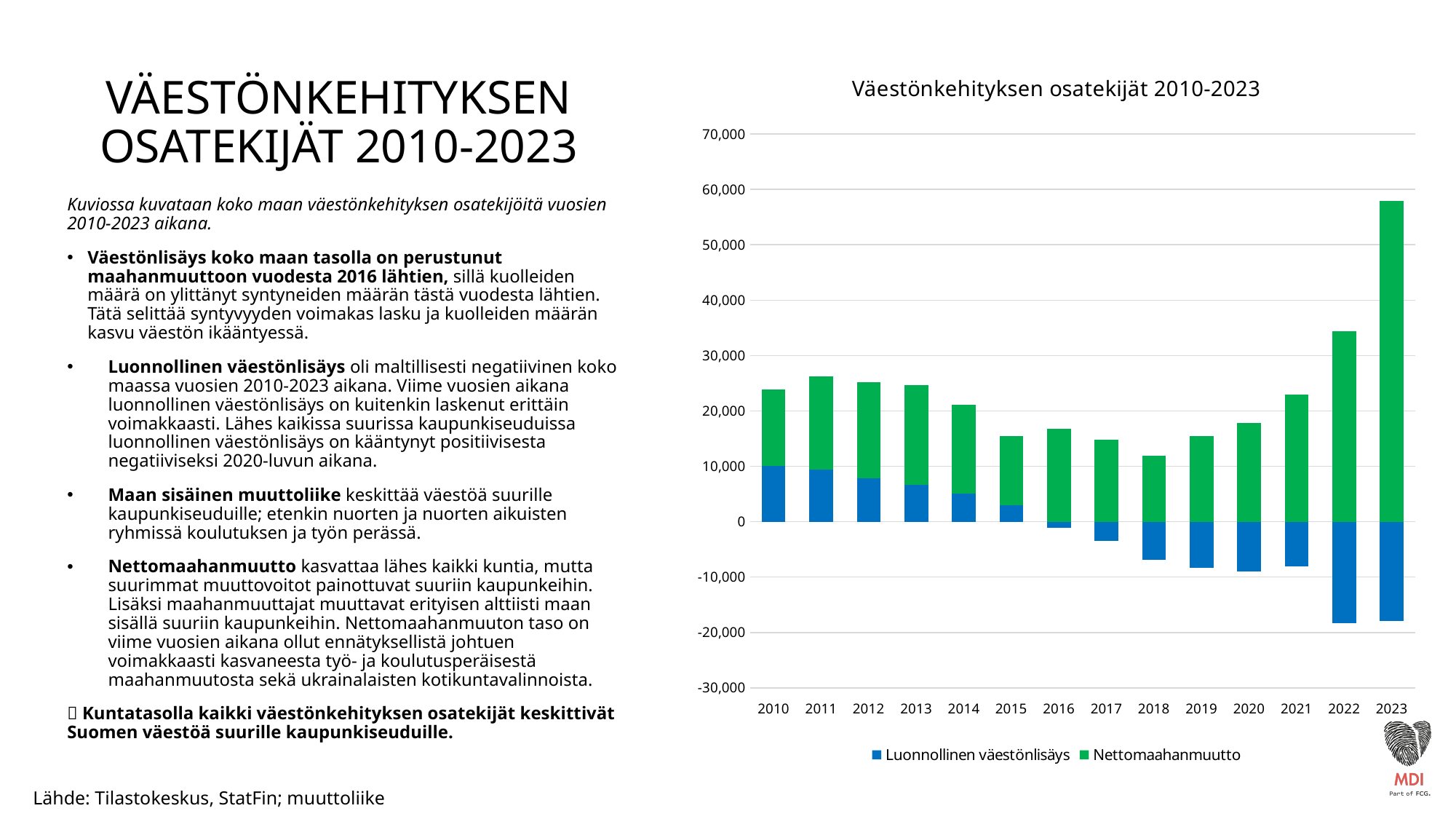
Is the value of Nettomaahanmuutto in 2022 greater or less than 30,000? greater Which year has the larger Nettomaahanmuutto, 2022 or 2023? 2023 Does Nettomaahanmuutto rise or fall from 2018 to 2023? rise What is the title of the chart? Väestönkehityksen osatekijät 2010-2023 Which series is shown in green in the chart? Nettomaahanmuutto Is the value of Luonnollinen väestönlisäys in 2022 greater or less than -10,000? less What kind of chart is shown on the slide? Stacked bar chart How many series does the chart legend list? 2 How many years are shown on the x axis of the chart? 14 In which year is Nettomaahanmuutto highest? 2023 Is the value of Nettomaahanmuutto in 2023 greater or less than 50,000? greater Which year has the larger Luonnollinen väestönlisäys, 2010 or 2015? 2010